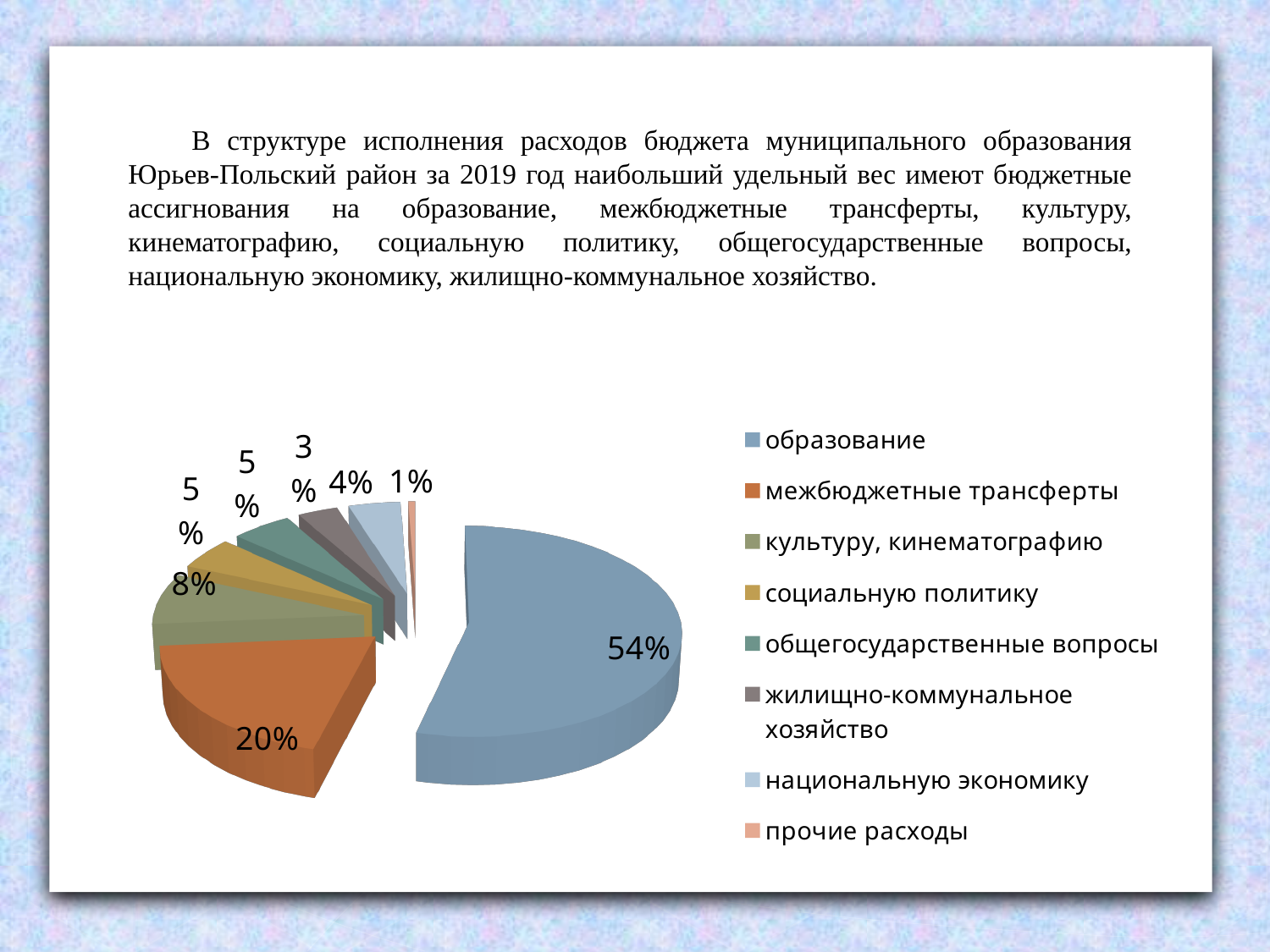
What share of the pie does образование have? 54% What is the difference between the shares of образование and межбюджетные трансферты? 34% Which is larger, the share for культуру, кинематографию or the share for национальную экономику? культуру, кинематографию What is the value shown for жилищно-коммунальное хозяйство? 3% Which category has the largest slice of the pie? образование What is the value shown for межбюджетные трансферты? 20% Which category has the smallest slice of the pie? прочие расходы What is the value shown for национальную экономику? 4% What kind of chart is shown on the slide? pie chart What colour is the slice for межбюджетные трансферты? orange How many entries does the legend list? 8 What is the value shown for культуру, кинематографию? 8%